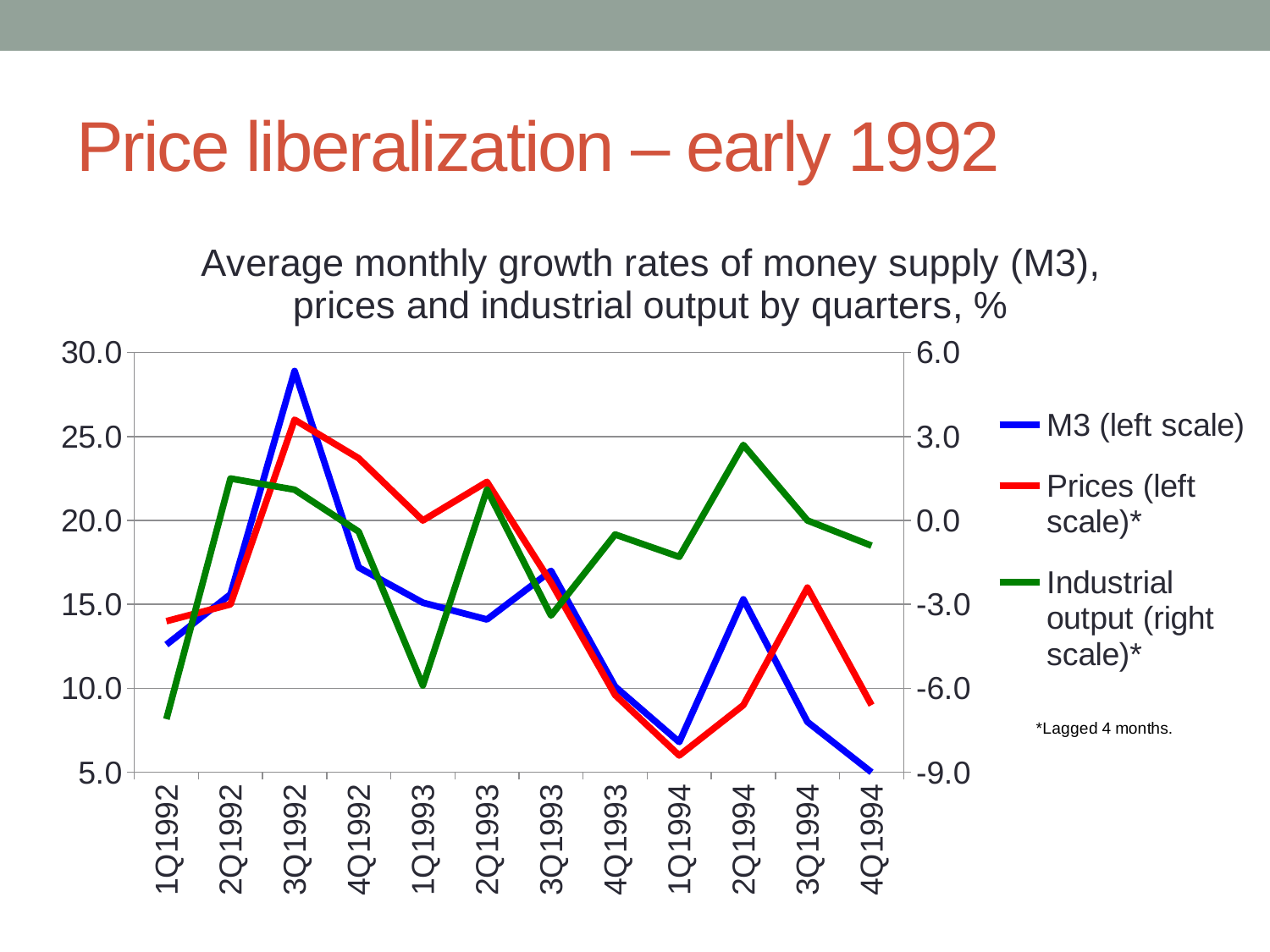
What does the footnote below the legend say? *Lagged 4 months. In which quarter does Industrial output reach its highest value? 2Q1994 How many series does the legend list? 3 In which quarter does Industrial output reach its lowest value? 1Q1992 In which quarter does M3 reach its highest value? 3Q1992 Is the value for Prices in 1Q1994 greater or less than 10.0? less Is the value for M3 in 3Q1992 greater or less than 25.0? greater What kind of chart is shown on the slide? line chart In 3Q1994, which is higher: M3 or Prices? Prices Is the value for Industrial output in 1Q1993 greater or less than -3.0? less How many quarters are plotted along the x axis? 12 In which quarter is the Prices series at its lowest? 1Q1994